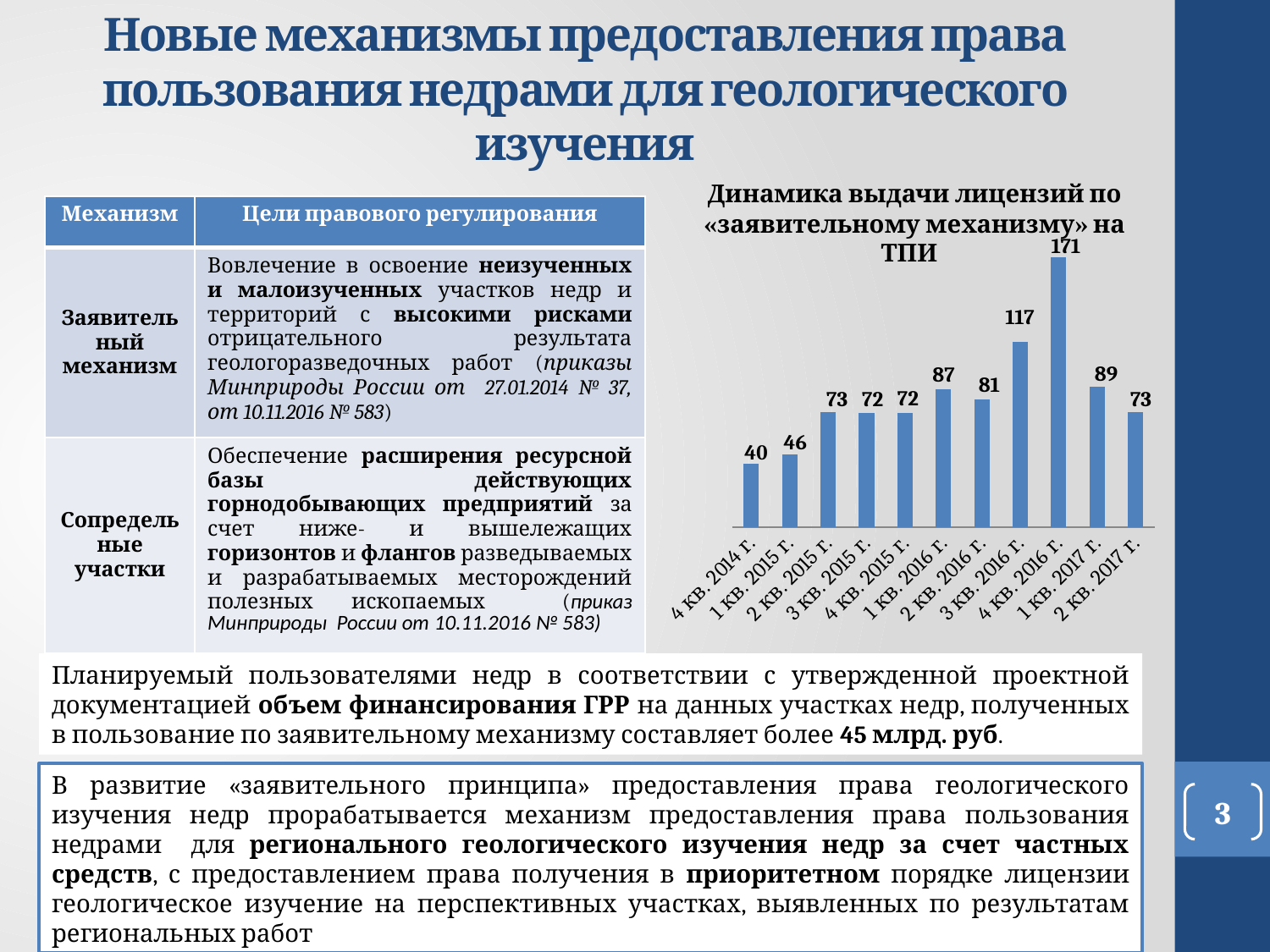
What is the value for 3 кв. 2016 г.? 117 What is the value for 4 кв. 2014 г.? 40 What is the difference between the values for 1 кв. 2015 г. and 4 кв. 2014 г.? 6 Which is larger, the value for 1 кв. 2016 г. or the value for 2 кв. 2016 г.? 1 кв. 2016 г. How many bars (quarters) are shown in the chart? 11 What type of chart is shown on the slide? bar chart What is the value for 4 кв. 2016 г.? 171 Which quarter has the highest value? 4 кв. 2016 г. What is the title of the chart on the slide? Динамика выдачи лицензий по «заявительному механизму» на ТПИ Which quarter has the lowest value? 4 кв. 2014 г. What is the difference between the values for 4 кв. 2016 г. and 3 кв. 2016 г.? 54 What is the value for 1 кв. 2017 г.? 89